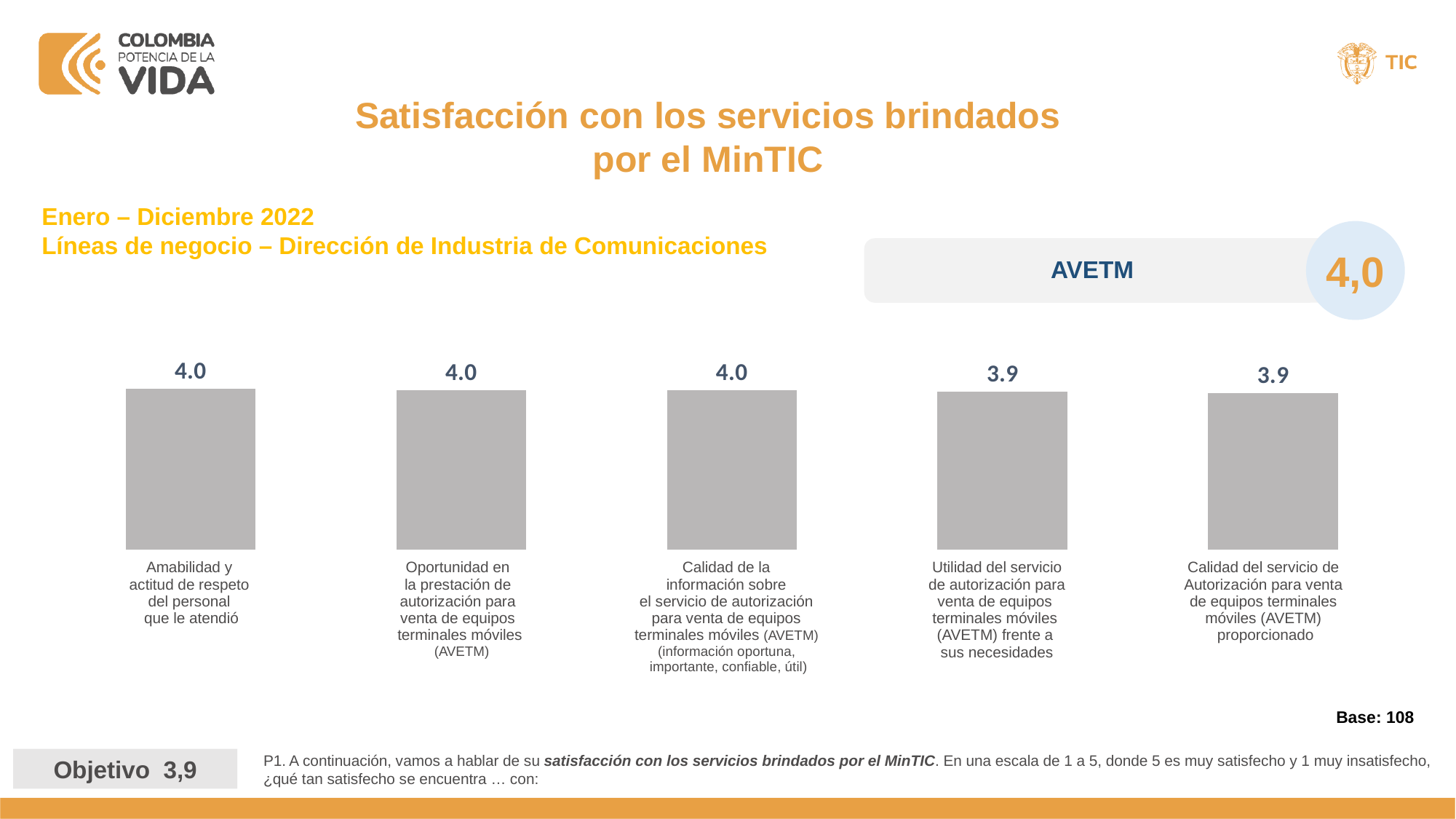
What is the difference between the value for 'Amabilidad y actitud de respeto del personal que le atendió' and the value for 'Utilidad del servicio de autorización para venta de equipos terminales móviles (AVETM) frente a sus necesidades'? 0.1 Do the values rise or fall from left to right across the chart? Fall What is the value shown for 'Utilidad del servicio de autorización para venta de equipos terminales móviles (AVETM) frente a sus necesidades'? 3.9 What kind of chart is shown on the slide? Bar chart What is the value for 'Calidad del servicio de Autorización para venta de equipos terminales móviles (AVETM) proporcionado'? 3.9 What is the lowest value shown on the chart? 3.9 What is the satisfaction score for 'Amabilidad y actitud de respeto del personal que le atendió'? 4.0 What is the value for 'Oportunidad en la prestación de autorización para venta de equipos terminales móviles (AVETM)'? 4.0 How many bars are shown on the chart? 5 What overall score is shown for AVETM in the circle at the top right of the slide? 4,0 Which has a higher value: 'Calidad de la información sobre el servicio de autorización' or 'Calidad del servicio de Autorización para venta de equipos terminales móviles (AVETM) proporcionado'? Calidad de la información sobre el servicio de autorización What is the highest value shown on the chart? 4.0